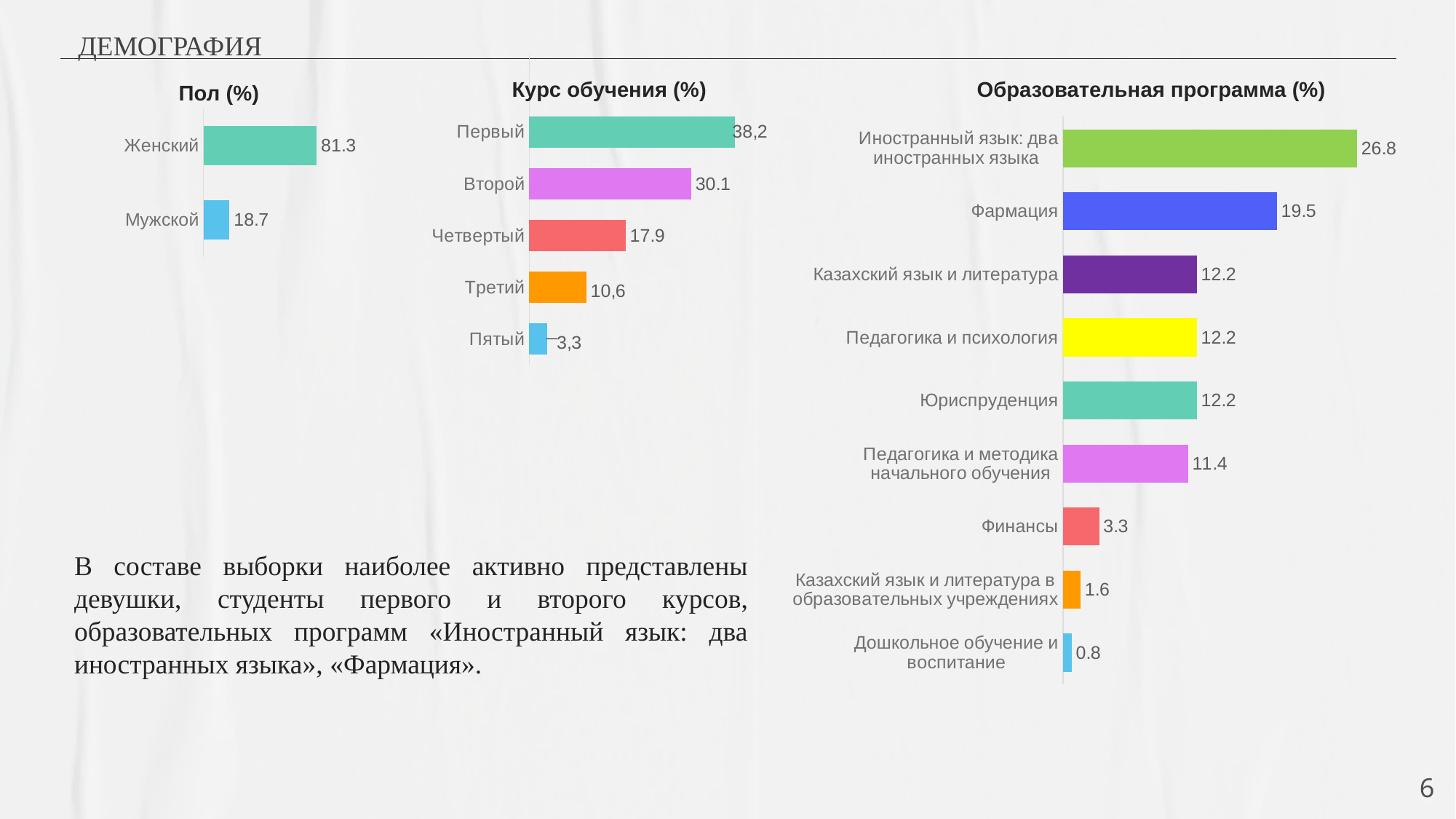
In the chart titled "Курс обучения (%)", which is larger, the value for Четвертый or the value for Третий? Четвертый In the chart titled "Пол (%)", what is the value for Мужской? 18.7 In the chart titled "Образовательная программа (%)", which category has the lowest value? Дошкольное обучение и воспитание In the chart titled "Образовательная программа (%)", how many categories are shown? 9 What kind of chart is the chart titled "Образовательная программа (%)"? bar chart In the chart titled "Пол (%)", what is the difference between the values for Женский and Мужской? 62.6 In the chart titled "Курс обучения (%)", how many categories are shown? 5 In the chart titled "Пол (%)", what is the value for Женский? 81.3 In the chart titled "Курс обучения (%)", which category has the lowest value? Пятый In the chart titled "Образовательная программа (%)", what is the value for Фармация? 19.5 In the chart titled "Курс обучения (%)", which category has the highest value? Первый In the chart titled "Курс обучения (%)", what is the value for Второй? 30.1